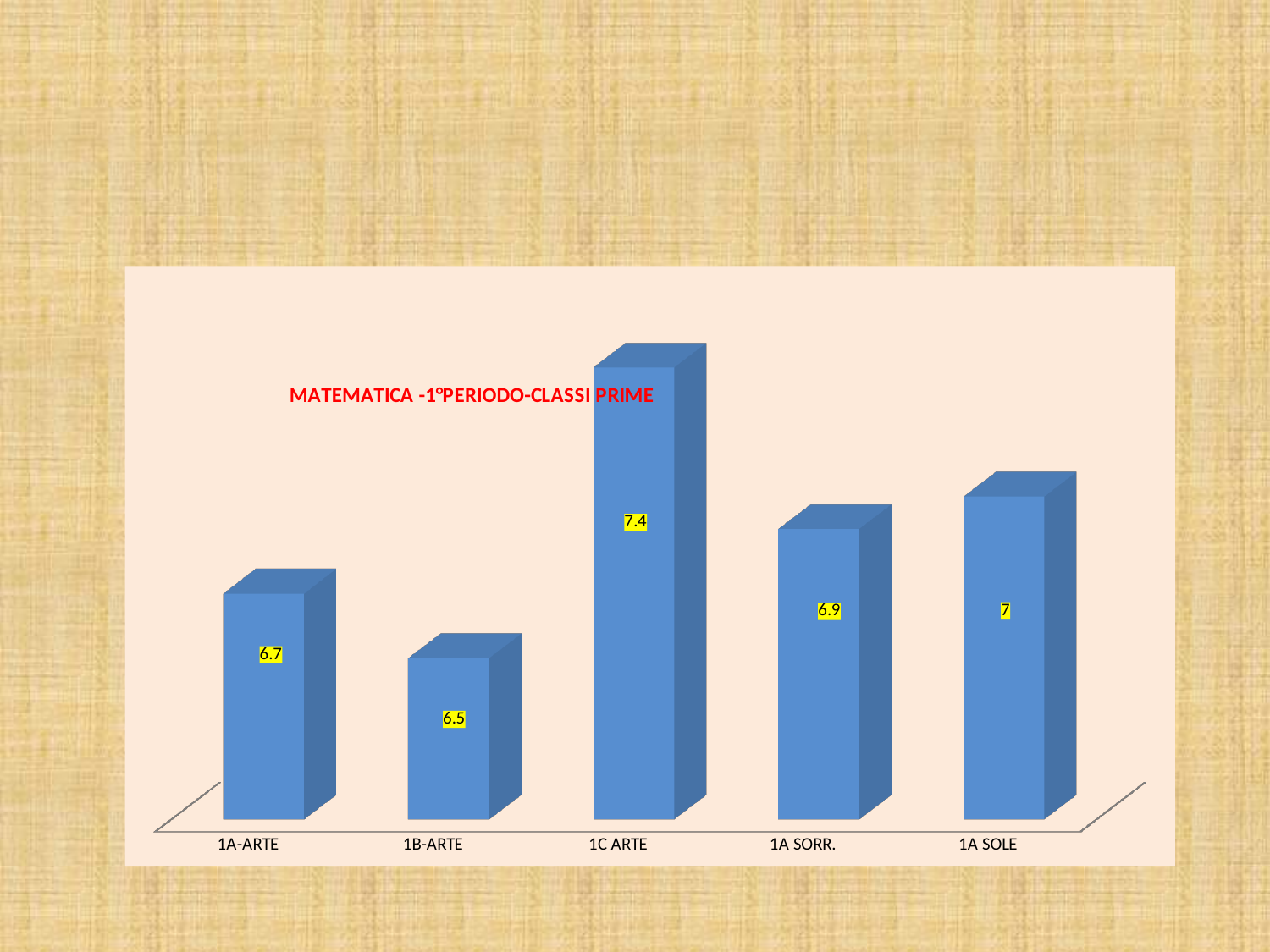
What is the value for 1C ARTE? 7.4 What is the value for 1A SORR.? 6.9 What is the value for 1B-ARTE? 6.5 Which is larger, the value for 1A SORR. or the value for 1A SOLE? 1A SOLE How many classes are shown in the chart? 5 What kind of chart is shown on the slide? Bar chart What is the difference between the values for 1C ARTE and 1B-ARTE? 0.9 What is the value for 1A-ARTE? 6.7 What is the title of the chart? MATEMATICA -1°PERIODO-CLASSI PRIME Which class has the highest value? 1C ARTE What is the value for 1A SOLE? 7 Which class has the lowest value? 1B-ARTE